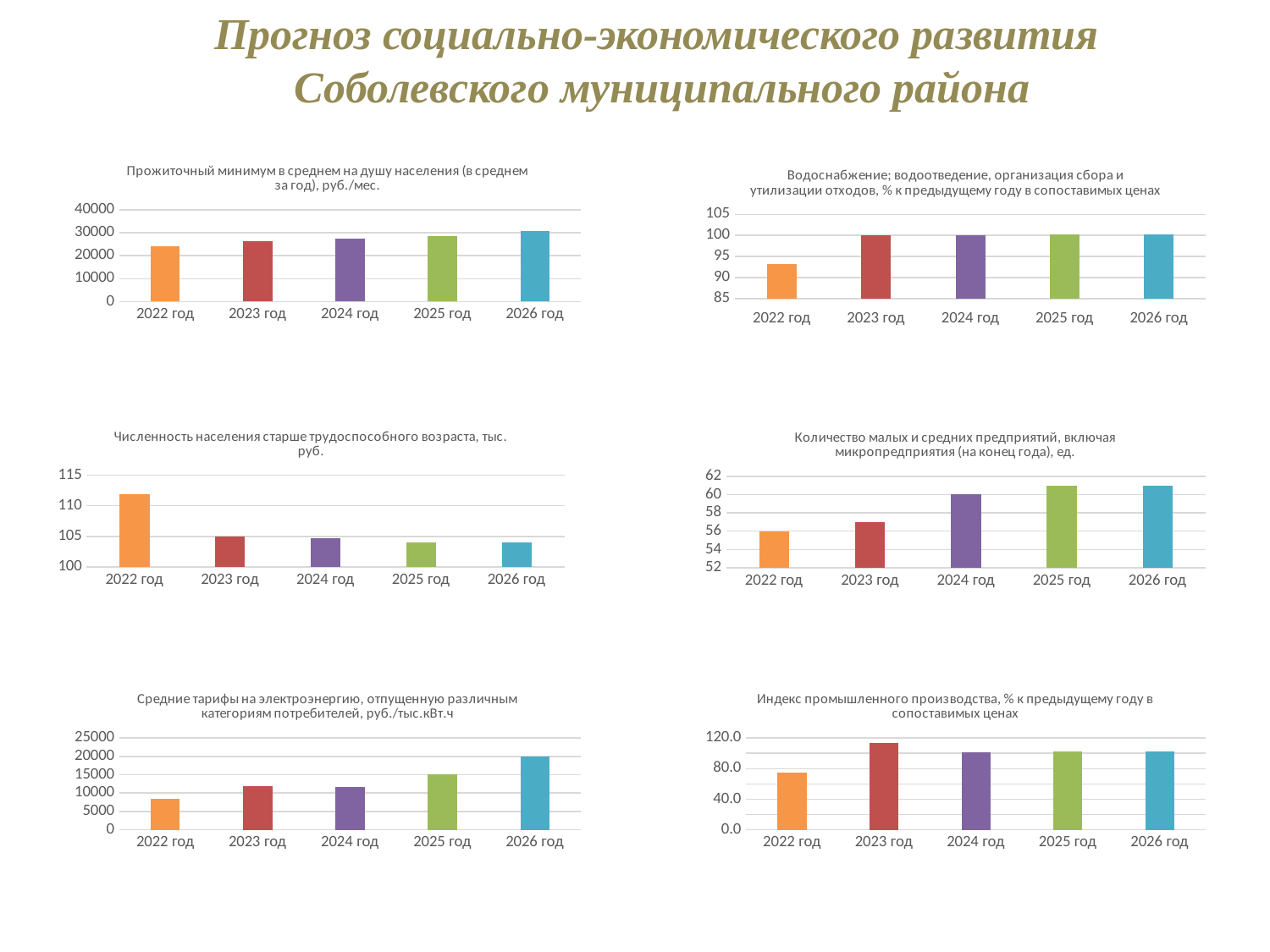
In the chart titled "Прожиточный минимум в среднем на душу населения", which year has the highest value? 2026 год In the chart titled "Прожиточный минимум в среднем на душу населения", do the values rise or fall from 2022 год to 2026 год? rise In the chart titled "Количество малых и средних предприятий", which year has the lowest value? 2022 год In the chart titled "Водоснабжение; водоотведение, организация сбора и утилизации отходов", is the value for 2022 год greater or less than 95? less In the chart titled "Численность населения старше трудоспособного возраста", which year has the highest value? 2022 год In the chart titled "Количество малых и средних предприятий", which is larger, the value for 2022 год or 2024 год? 2024 год In the chart titled "Индекс промышленного производства", which year has the highest value? 2023 год In the chart titled "Численность населения старше трудоспособного возраста", is the value for 2022 год greater or less than 110? greater How many years are shown on the x axis of the chart titled "Индекс промышленного производства"? 5 In the chart titled "Средние тарифы на электроэнергию", is the value for 2022 год greater or less than 10000? less In the chart titled "Водоснабжение; водоотведение, организация сбора и утилизации отходов", which year has the lowest value? 2022 год